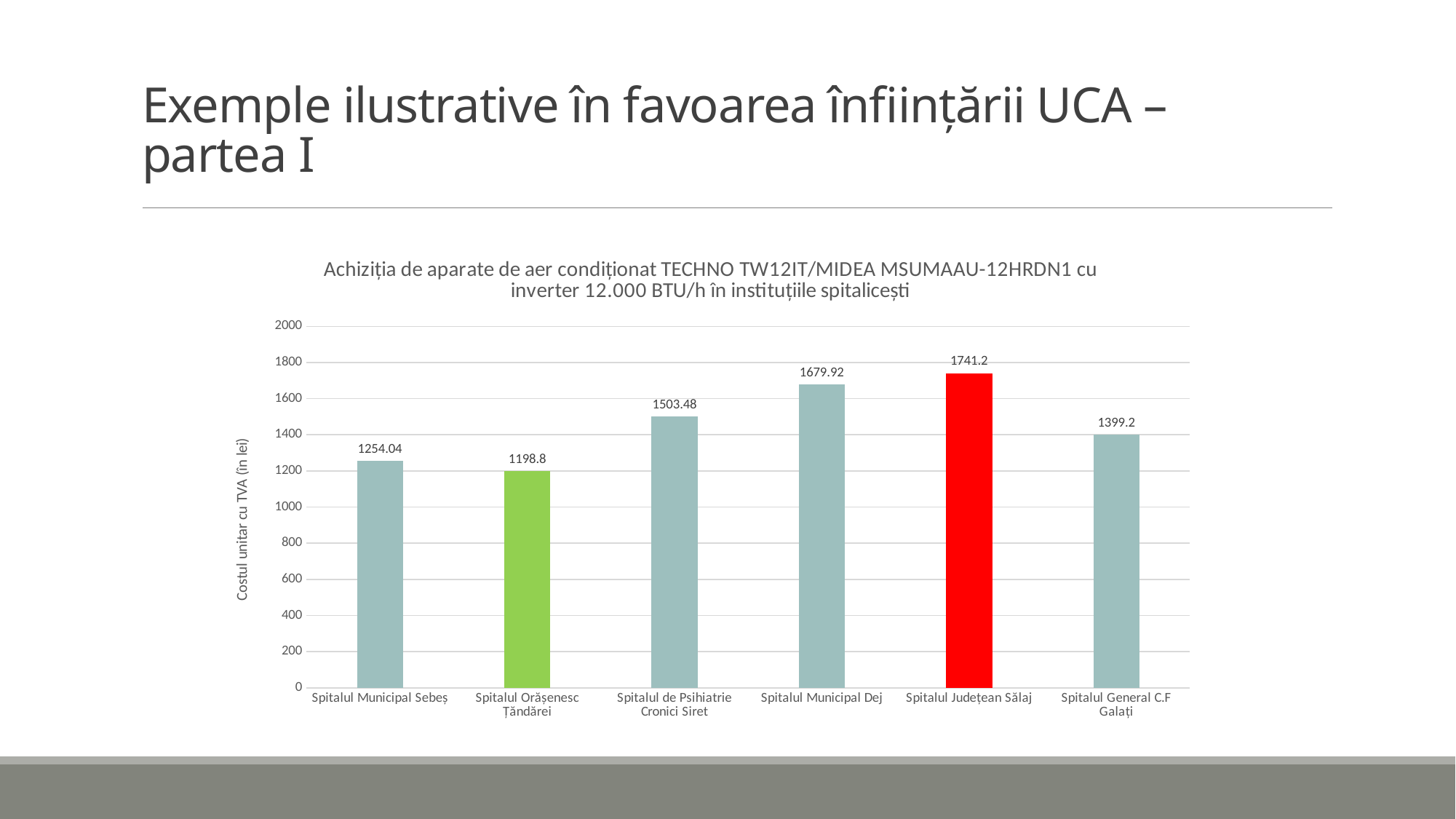
What kind of chart is shown on the slide? bar chart Is the value for Spitalul Municipal Dej greater or less than 1600? greater What is the unit cost for Spitalul de Psihiatrie Cronici Siret? 1503.48 What is the difference between the unit cost for Spitalul Județean Sălaj and Spitalul Orășenesc Țăndărei? 542.4 Which has a higher unit cost, Spitalul Municipal Sebeș or Spitalul General C.F Galați? Spitalul General C.F Galați Which hospital has the highest unit cost? Spitalul Județean Sălaj What is the difference between the unit cost for Spitalul Municipal Dej and Spitalul de Psihiatrie Cronici Siret? 176.44 Which hospital has the lowest unit cost? Spitalul Orășenesc Țăndărei What is the unit cost for Spitalul Orășenesc Țăndărei? 1198.8 What is the unit cost for Spitalul General C.F Galați? 1399.2 What is the unit cost for Spitalul Municipal Sebeș? 1254.04 How many hospitals are shown in the chart? 6